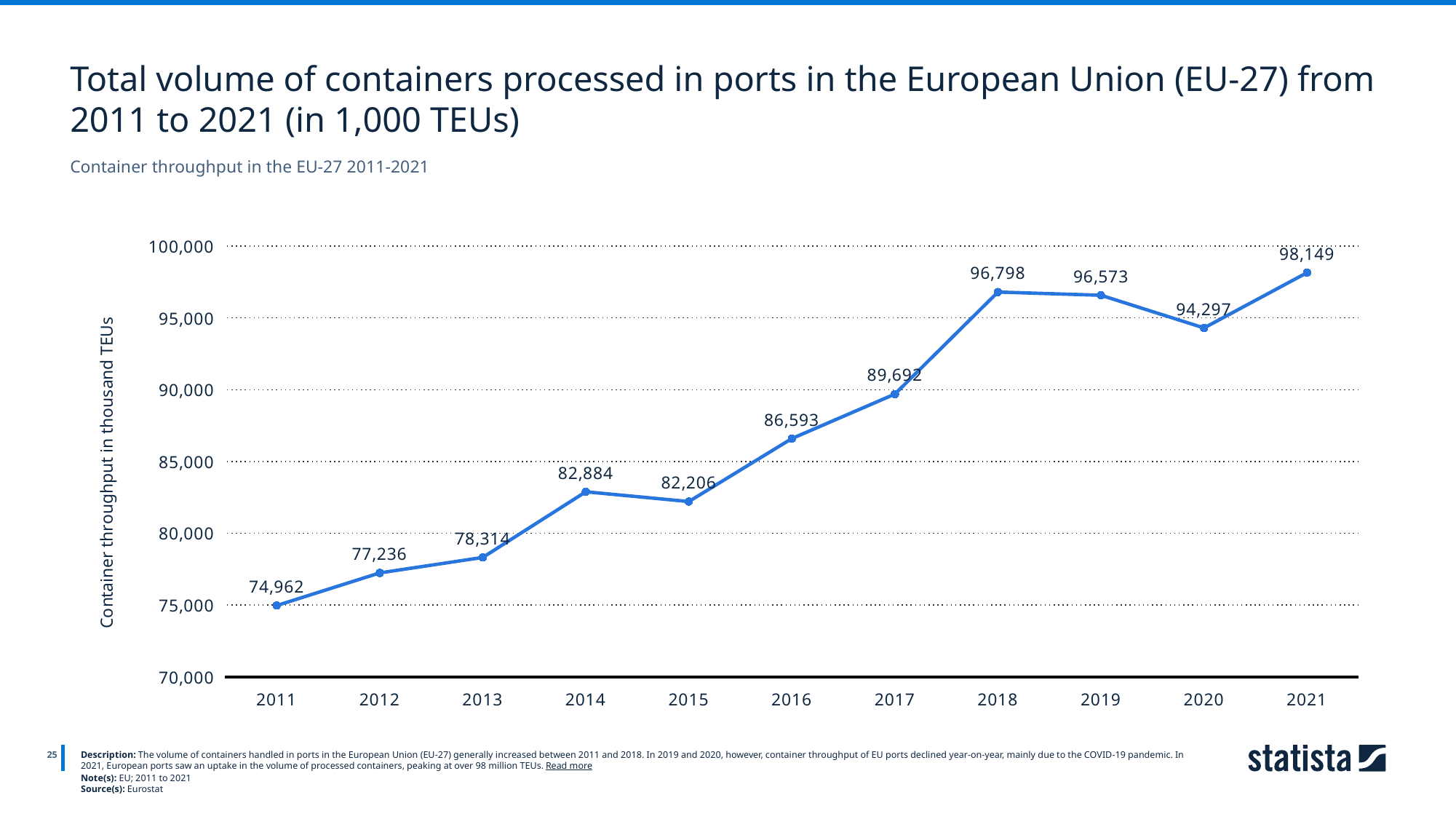
Is the value for 2017 greater or less than 90,000? less Which year had a higher container throughput, 2014 or 2015? 2014 Which year had the lowest container throughput? 2011 What is the difference in container throughput between 2021 and 2011? 23,187 What was the container throughput in the EU-27 in 2018? 96,798 What was the container throughput in the EU-27 in 2011? 74,962 What is the label of the y axis? Container throughput in thousand TEUs How many years are plotted on the chart? 11 What was the container throughput in the EU-27 in 2020? 94,297 Which year had the highest container throughput? 2021 What is the difference in container throughput between 2018 and 2019? 225 What kind of chart is shown on the slide? line chart